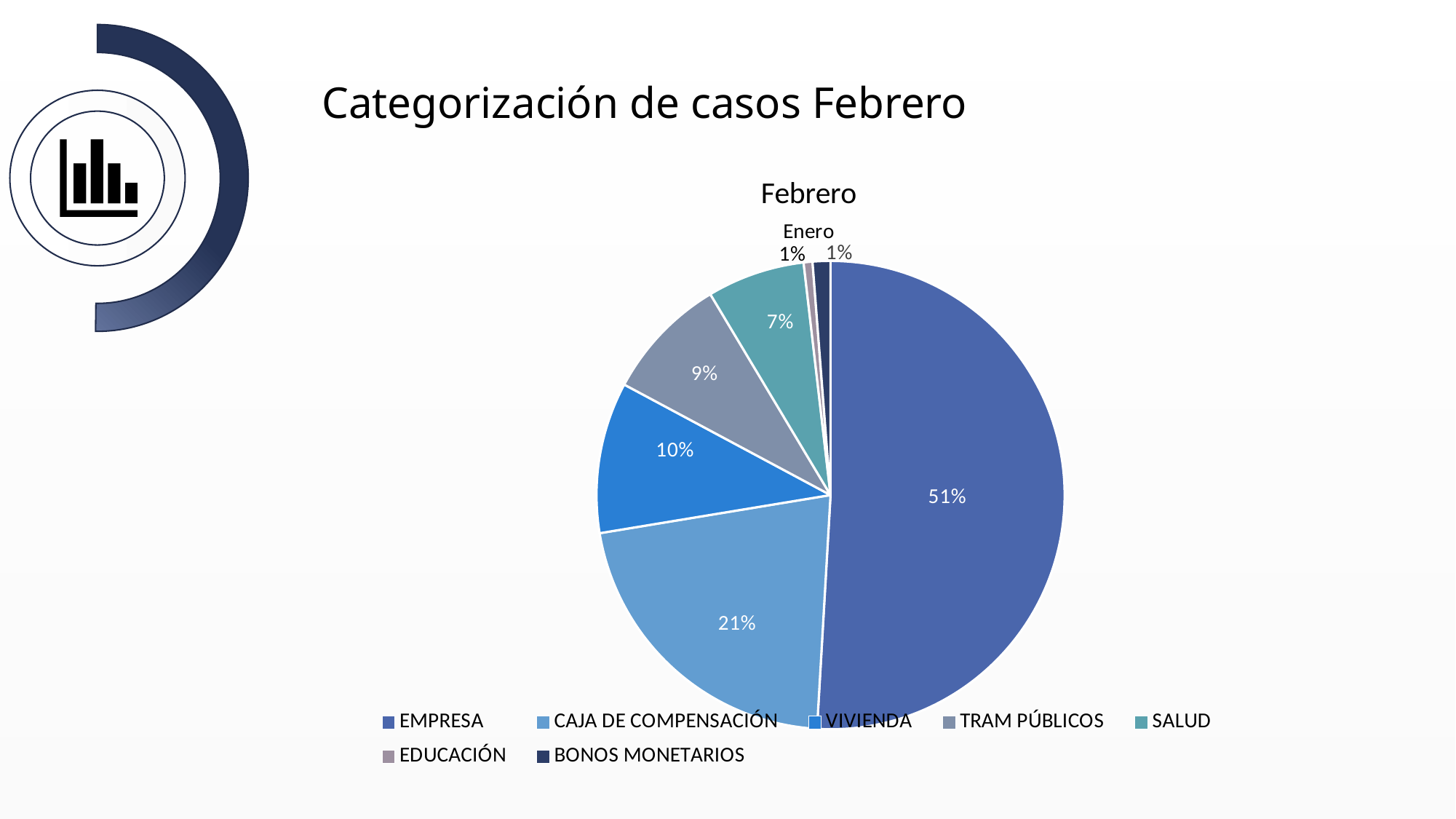
What share of the pie does CAJA DE COMPENSACIÓN have? 21% What share of the pie does SALUD have? 7% What is the difference between the TRAM PÚBLICOS share and the SALUD share? 2% What is the chart's title? Febrero What share of the pie does EMPRESA have? 51% What is the difference between the EMPRESA share and the CAJA DE COMPENSACIÓN share? 30% Which is larger, the VIVIENDA slice or the SALUD slice? VIVIENDA How many categories does the legend list? 7 What kind of chart is shown on the slide? pie chart Which category has the largest slice of the pie? EMPRESA